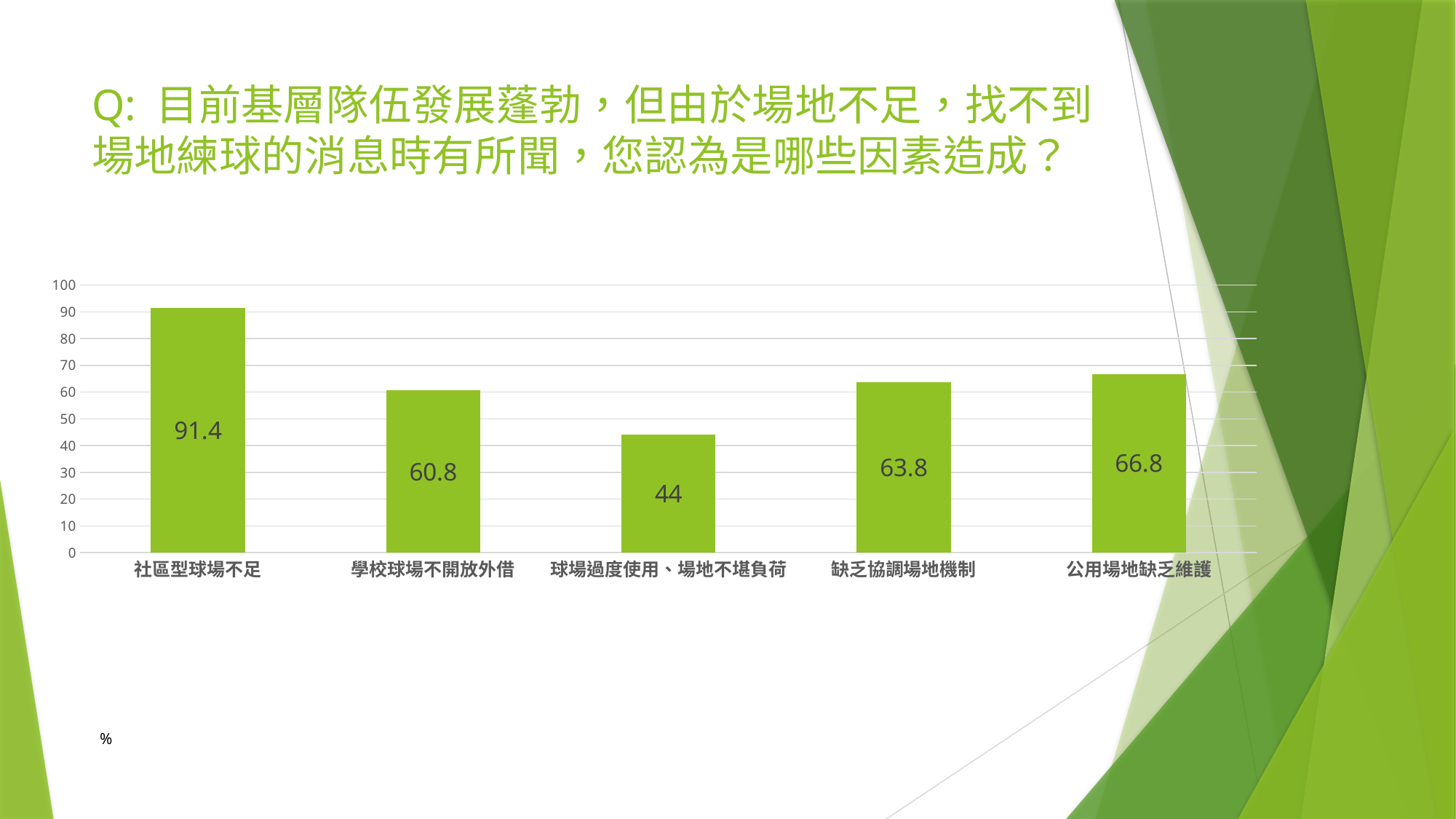
How many categories are shown in the chart? 5 What is the value for 缺乏協調場地機制? 63.8 Which is larger, the value for 公用場地缺乏維護 or the value for 學校球場不開放外借? 公用場地缺乏維護 Which category has the lowest value? 球場過度使用、場地不堪負荷 What kind of chart is shown on the slide? bar chart What is the value for 公用場地缺乏維護? 66.8 What is the difference between the values for 社區型球場不足 and 球場過度使用、場地不堪負荷? 47.4 Is the value for 缺乏協調場地機制 greater or less than 50? greater What is the value for 社區型球場不足? 91.4 What is the value for 學校球場不開放外借? 60.8 Which category has the highest value? 社區型球場不足 What is the value for 球場過度使用、場地不堪負荷? 44